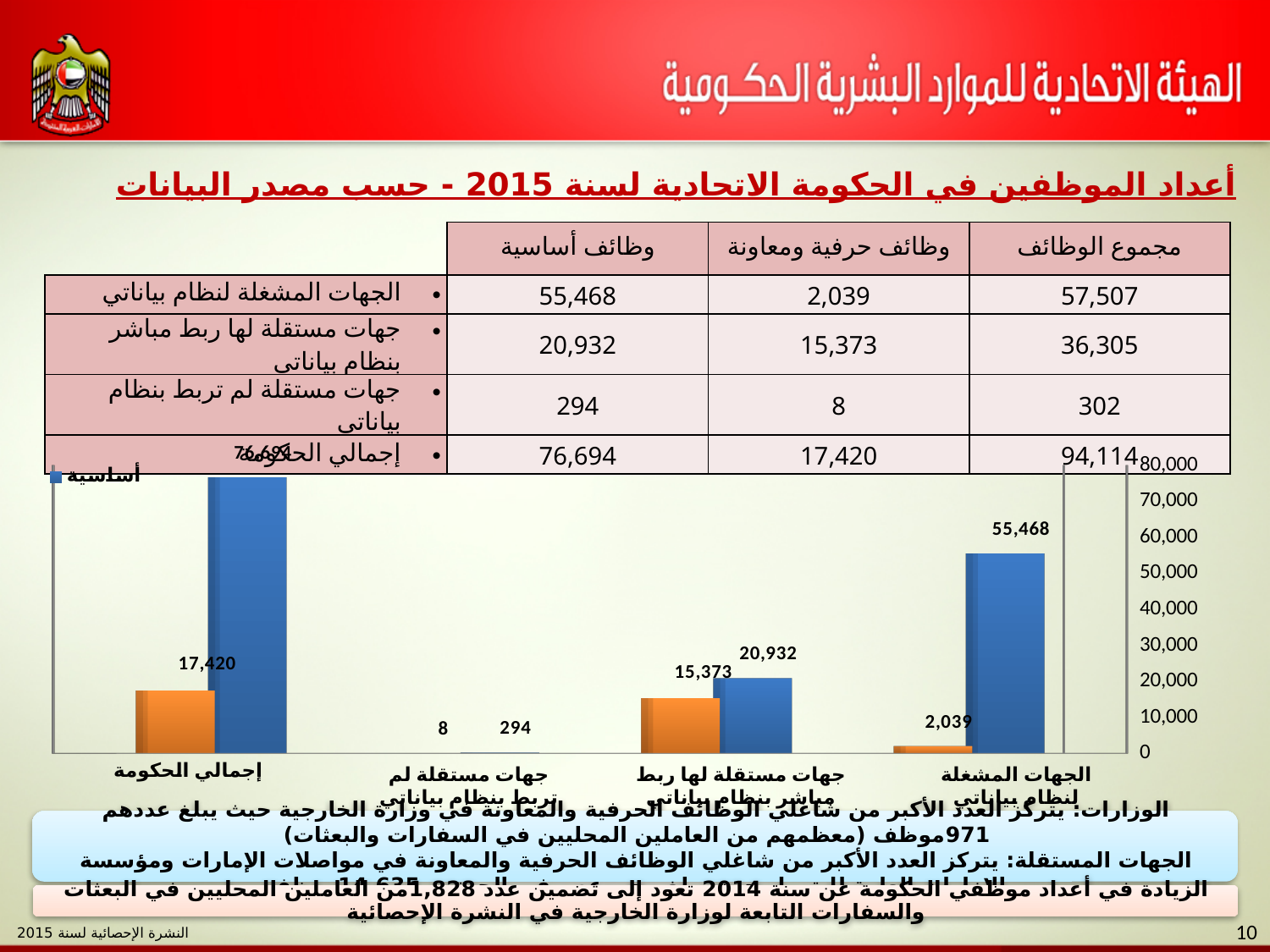
In the chart, what is the value of the orange bar for جهات مستقلة لها ربط مباشر بنظام بياناتي? 15,373 In the chart, what is the value of the orange bar for الجهات المشغلة لنظام بياناتي? 2,039 In the chart, what is the difference between the blue bar and the orange bar for جهات مستقلة لها ربط مباشر بنظام بياناتي? 5,559 In the chart, what is the value of the blue bar for جهات مستقلة لها ربط مباشر بنظام بياناتي? 20,932 In the chart, what is the value of the orange bar for إجمالي الحكومة? 17,420 What type of chart is shown on the slide? bar chart In the chart, is the blue bar for إجمالي الحكومة greater or less than 70,000? greater How many categories are shown on the x axis of the chart? 4 In the chart, what is the value of the blue bar for جهات مستقلة لم تربط بنظام بياناتي? 294 In the chart, which category has the lowest orange bar? جهات مستقلة لم تربط بنظام بياناتي In the chart, which is larger for الجهات المشغلة لنظام بياناتي: the blue bar or the orange bar? the blue bar In the chart, what is the value of the blue bar for الجهات المشغلة لنظام بياناتي? 55,468